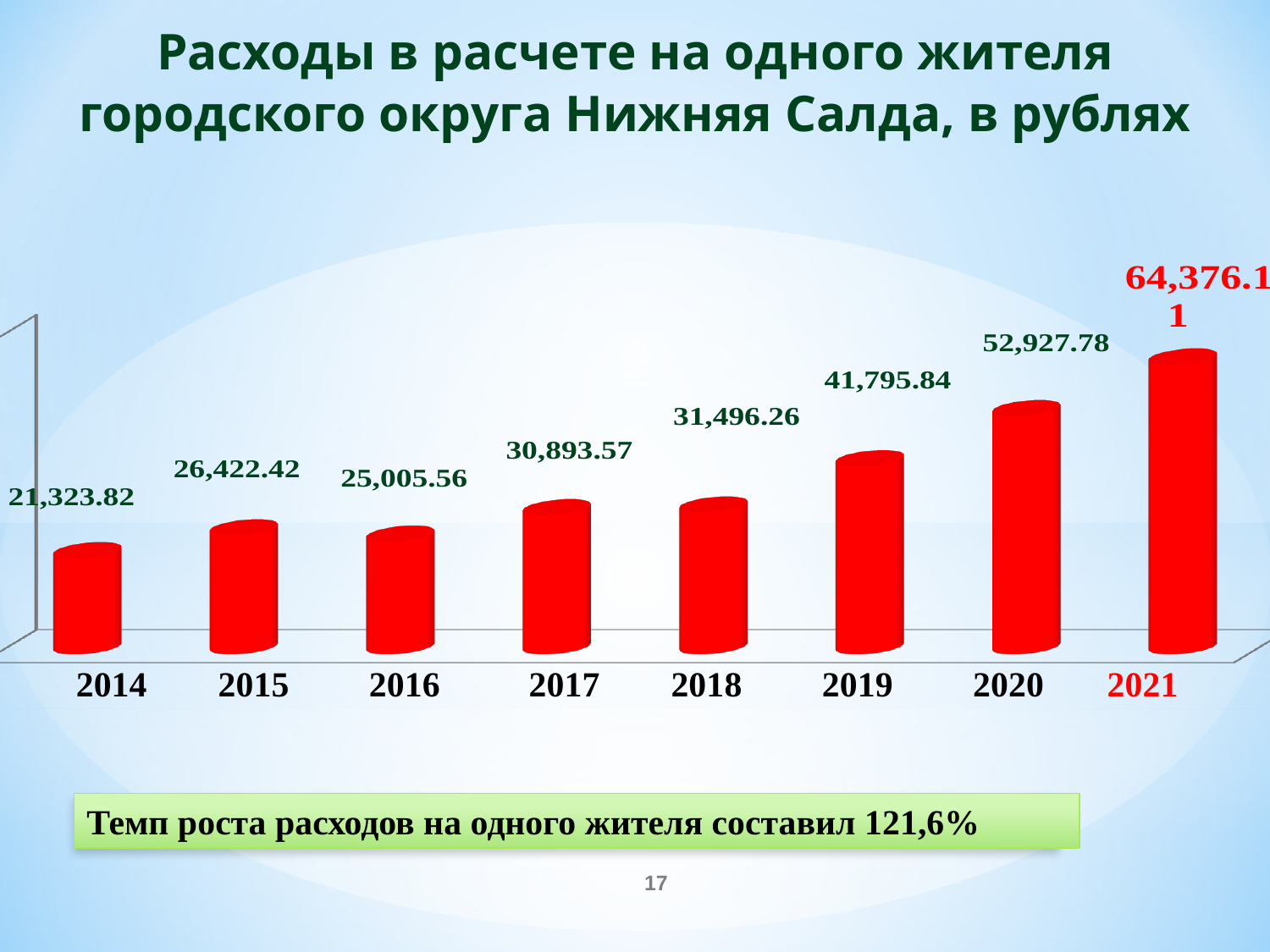
What is the value for 2021? 64,376.11 What is the difference between the values for 2021 and 2020? 11,448.33 Do the values generally rise or fall from 2014 to 2021? Rise What kind of chart is shown on the slide? Bar chart Which year has the highest value? 2021 What is the value for 2019? 41,795.84 How many years are shown on the chart? 8 What is the value for 2017? 30,893.57 Which year has the lowest value? 2014 What is the value for 2014? 21,323.82 What is the difference between the values for 2015 and 2016? 1,416.86 Which is larger, the value for 2015 or the value for 2016? 2015